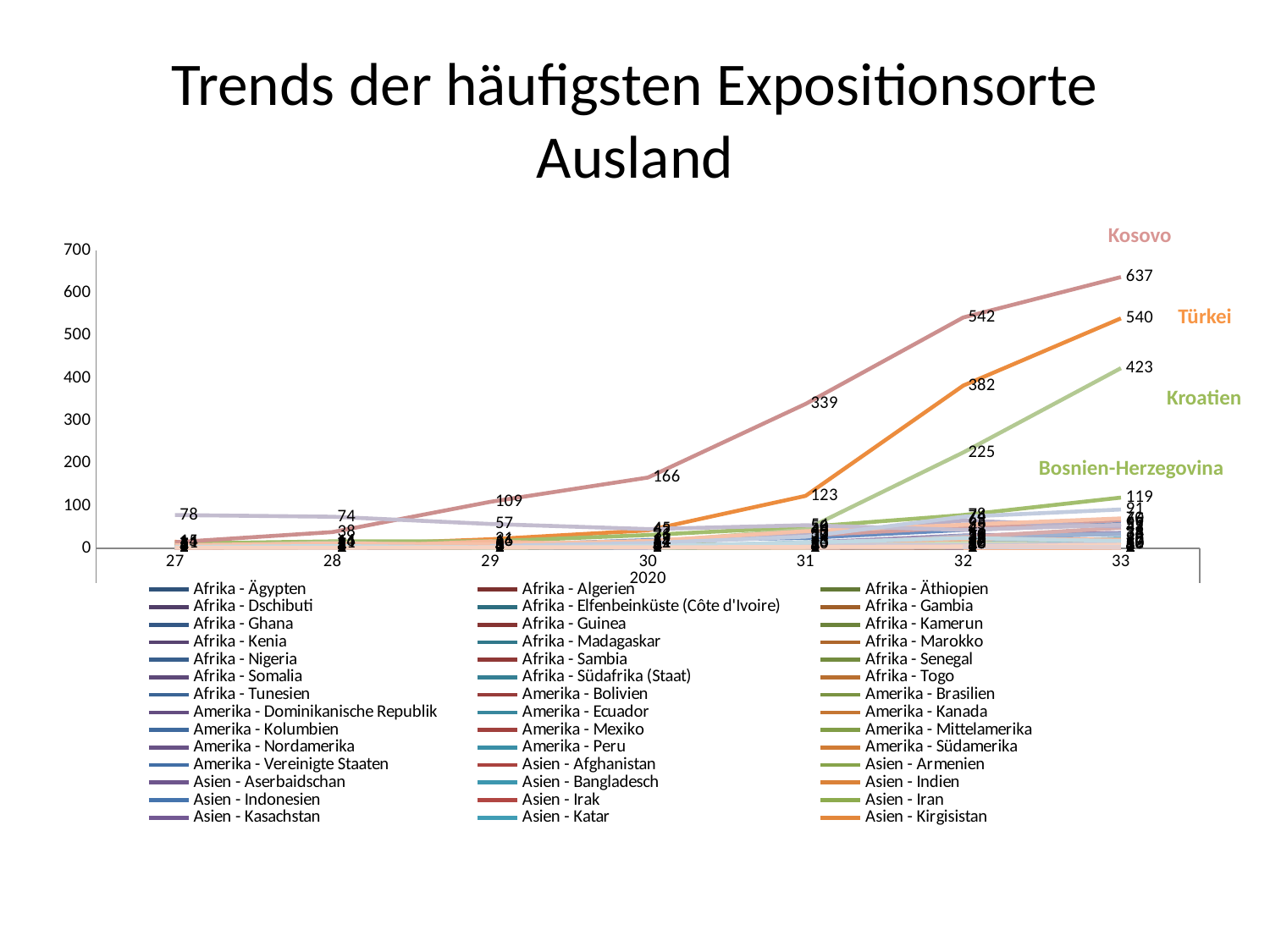
What is the value for Kosovo at week 32? 542 Which labelled country has the highest value at week 33? Kosovo Which is larger at week 32, the value for Türkei or the value for Kroatien? Türkei What kind of chart is shown on the slide? line chart What is the value for Türkei at week 33? 540 What is the value for Bosnien-Herzegovina at week 33? 119 How many points are shown on the x axis? 7 Does the Kosovo line rise or fall from week 27 to week 33? rises What is the value for Kosovo at week 33? 637 What is the difference between the Kosovo and Türkei values at week 33? 97 What is the value for Türkei at week 32? 382 What is the value for Kroatien at week 33? 423